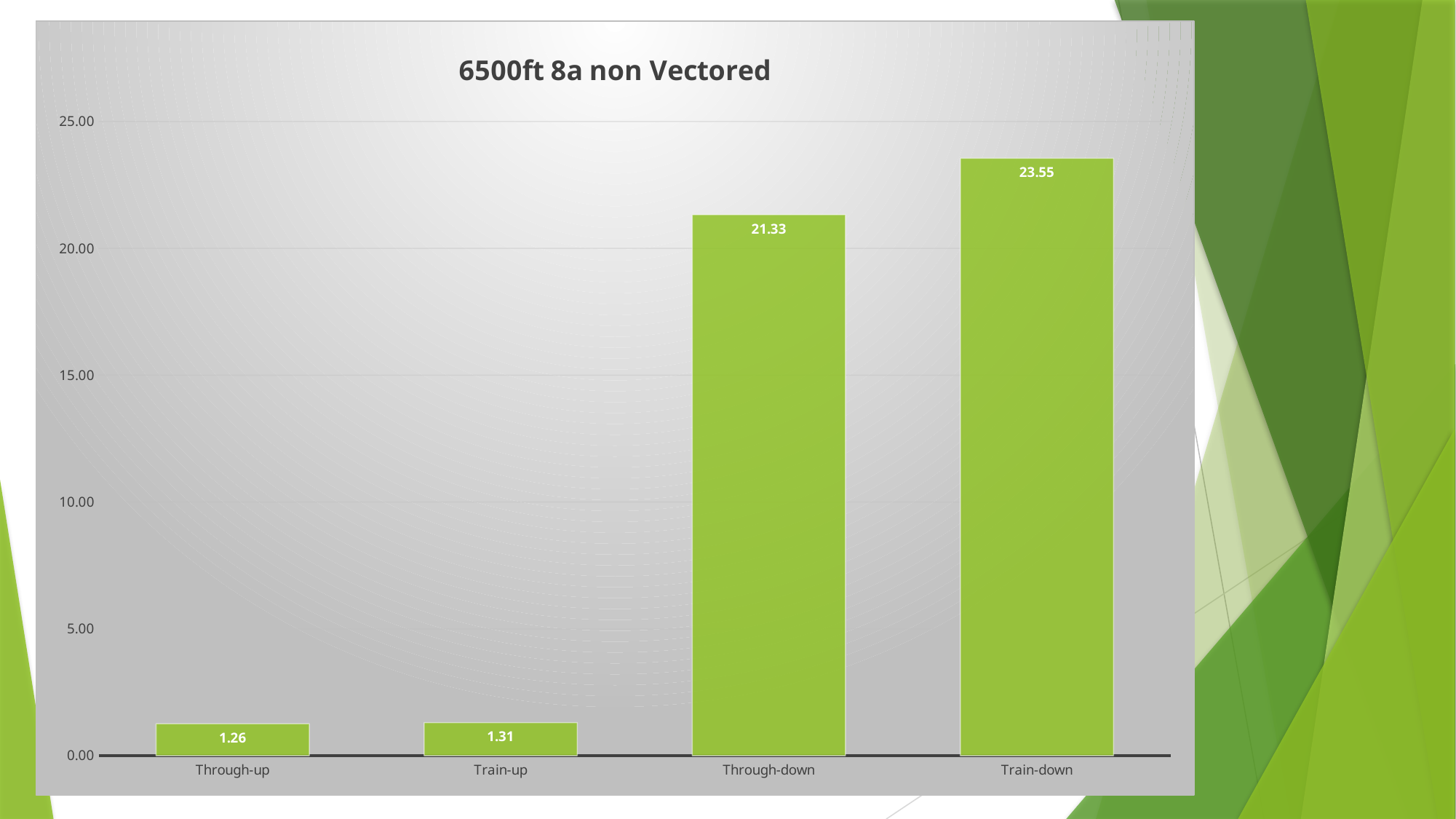
What is the value for Train-up? 1.31 What is the value for Through-up? 1.26 Which category has the highest value? Train-down How many categories are shown on the x axis? 4 What is the value for Through-down? 21.33 What is the title of the chart? 6500ft 8a non Vectored Which is larger, the value for Through-down or the value for Train-down? Train-down What kind of chart is shown on the slide? bar chart Is the value for Through-down greater or less than 20.00? greater What is the value for Train-down? 23.55 Which category has the lowest value? Through-up What is the difference between the values for Train-down and Through-down? 2.22